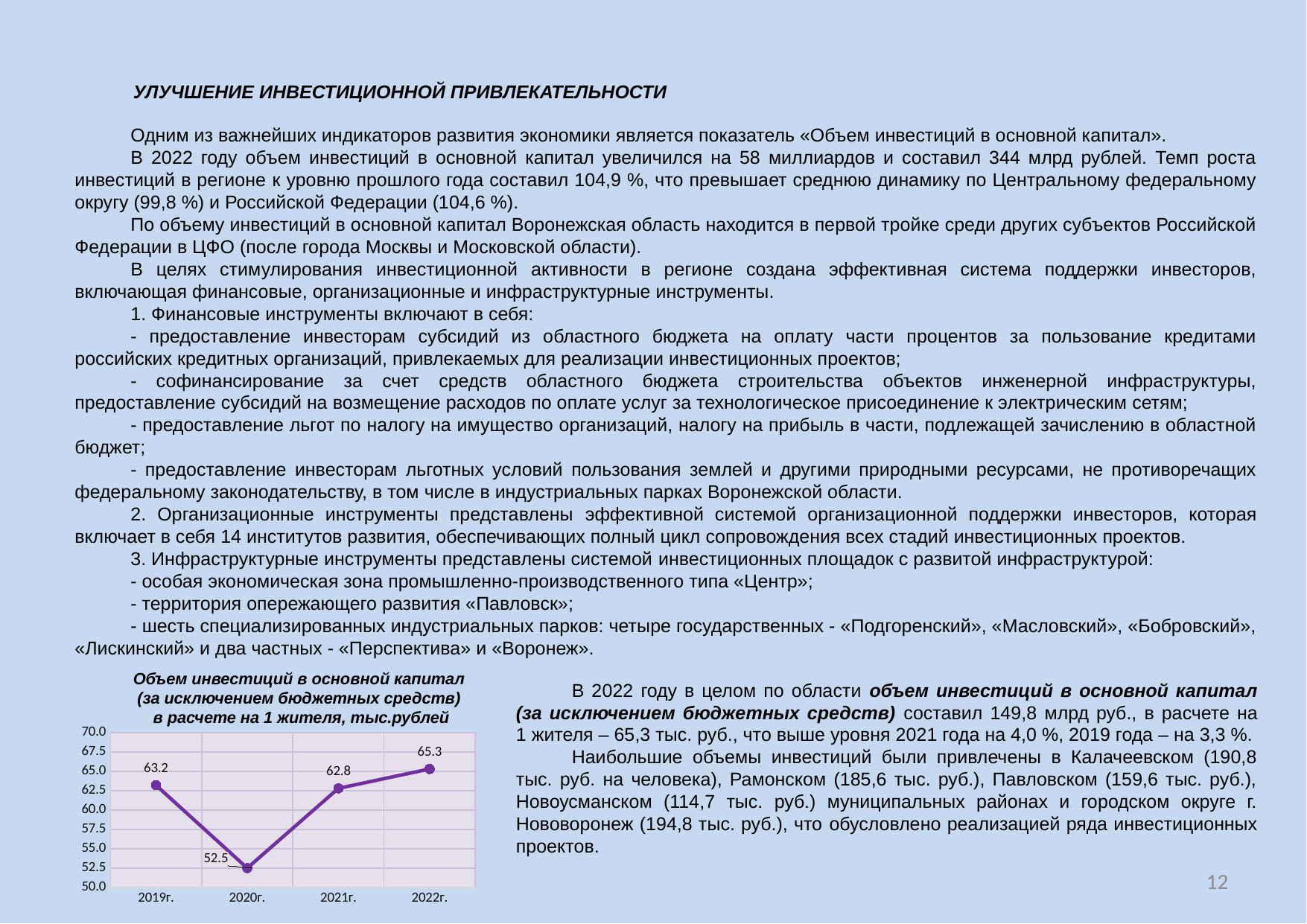
Is the value for 2020г. greater or less than 55.0? less What is the value for 2019г. on the chart? 63.2 Which year has the highest value on the chart? 2022г. What is the value for 2020г. on the chart? 52.5 What kind of chart is shown on the slide? line chart Which is larger, the value for 2019г. or the value for 2020г.? 2019г. Which year has the lowest value on the chart? 2020г. What is the difference between the values for 2022г. and 2020г.? 12.8 Do the values rise or fall from 2020г. to 2022г.? rise How many years are plotted on the chart? 4 What is the value for 2021г. on the chart? 62.8 What is the value for 2022г. on the chart? 65.3